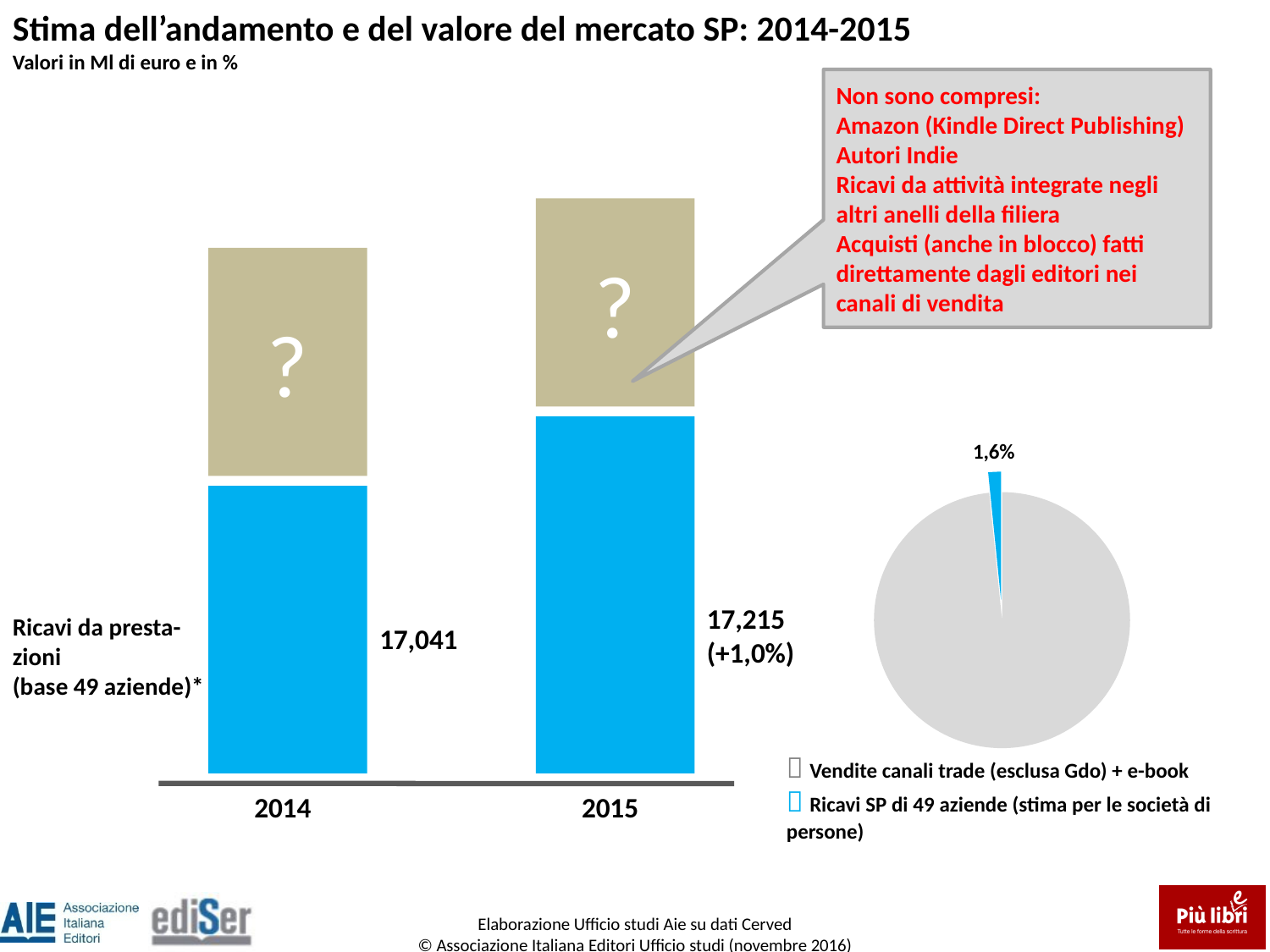
In the pie chart, which slice is larger, the grey one or the blue one? The grey one In the bar chart, what symbol is printed inside the tan segments on top of the blue bars? ? In the bar chart, what value is printed for the blue bar in 2015? 17,215 What kind of chart is the one on the left of the slide showing 2014 and 2015? Bar chart In the bar chart, what value is printed for the blue bar in 2014? 17,041 How many entries does the legend of the pie chart list? 2 In the pie chart, what share is printed for the blue slice? 1,6% How many years are shown on the x axis of the bar chart? 2 In the bar chart, what percentage change is printed next to the 2015 value? +1,0% In the bar chart, do the printed blue-bar values rise or fall from 2014 to 2015? Rise In the bar chart, which year has the higher printed value for the blue bar, 2014 or 2015? 2015 In the bar chart, what is the difference between the printed 2015 value and the printed 2014 value? 174